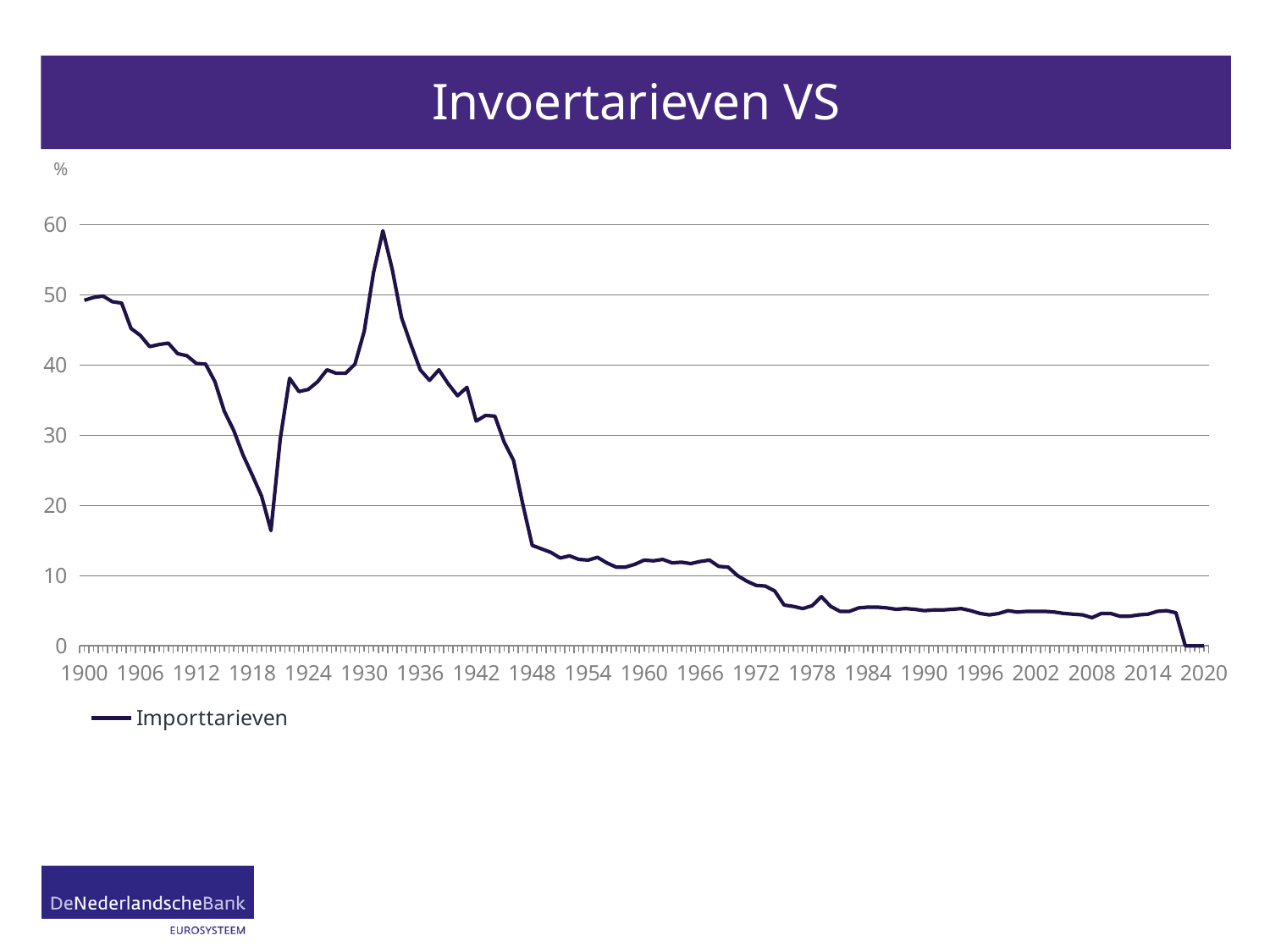
What is the title of the chart? Invoertarieven VS Is the value for 1924 greater or less than 30? greater Is the value for 2014 greater or less than 10? less Is the value for 1948 greater or less than 20? less What is the name of the series shown in the legend? Importtarieven In which decade does the line reach its highest point? 1930s How many series does the legend list? 1 What kind of chart is shown on the slide? Line chart Which is larger, the value for 1900 or the value for 2020? 1900 Overall, do the import tariff values rise or fall from 1900 to 2020? Fall